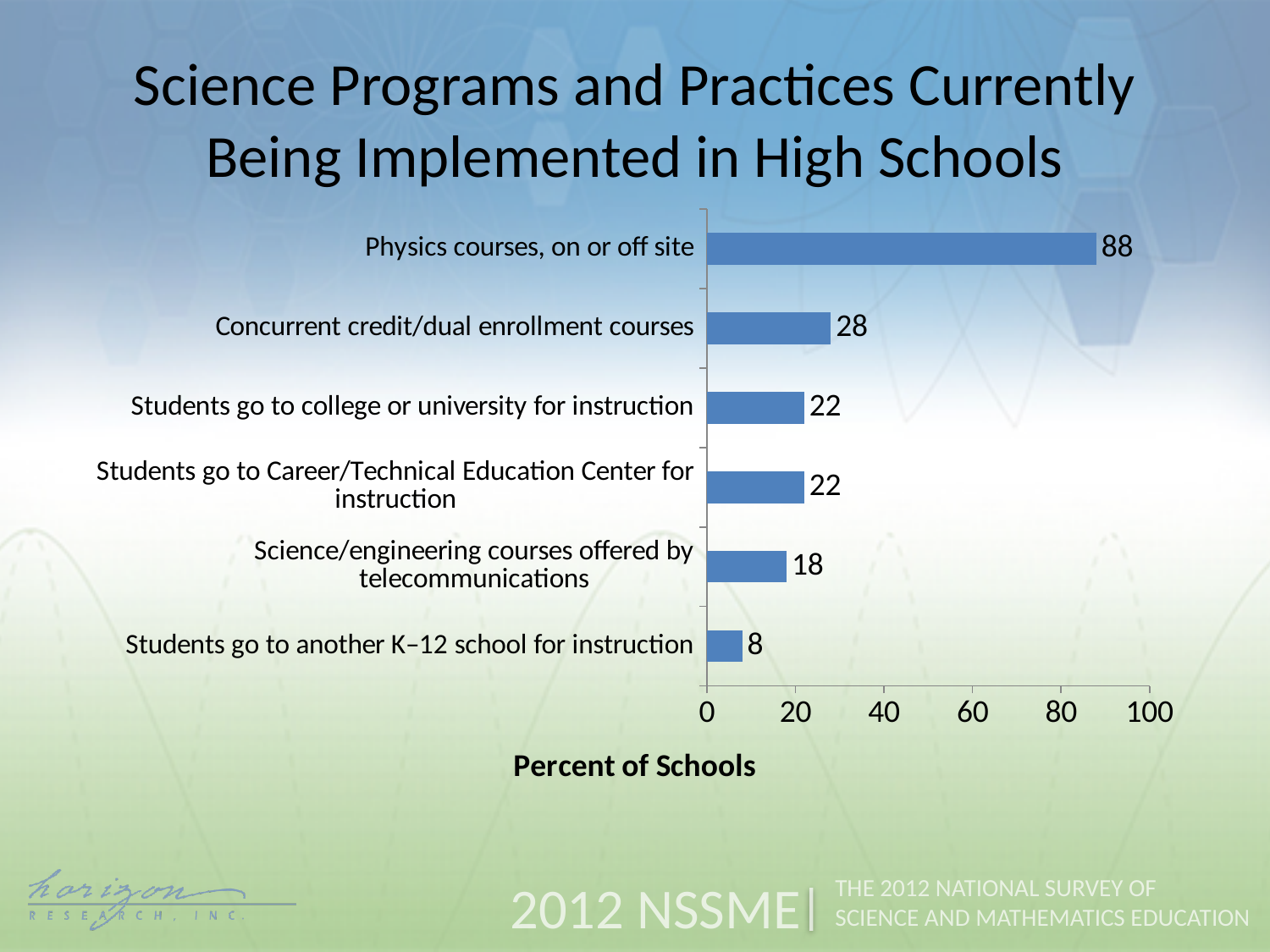
What is the label of the horizontal axis? Percent of Schools What is the difference between the value for students go to college or university for instruction and the value for science/engineering courses offered by telecommunications? 4 How many categories are shown in the chart? 6 What is the difference between the value for physics courses, on or off site and the value for concurrent credit/dual enrollment courses? 60 What kind of chart is shown on the slide? Bar chart What percent of schools have students go to another K–12 school for instruction? 8 What is the value for concurrent credit/dual enrollment courses? 28 Which category has the highest value? Physics courses, on or off site What is the value for science/engineering courses offered by telecommunications? 18 Which category has the lowest value? Students go to another K–12 school for instruction Which is larger: the value for concurrent credit/dual enrollment courses or the value for students go to Career/Technical Education Center for instruction? Concurrent credit/dual enrollment courses What percent of schools have physics courses, on or off site? 88